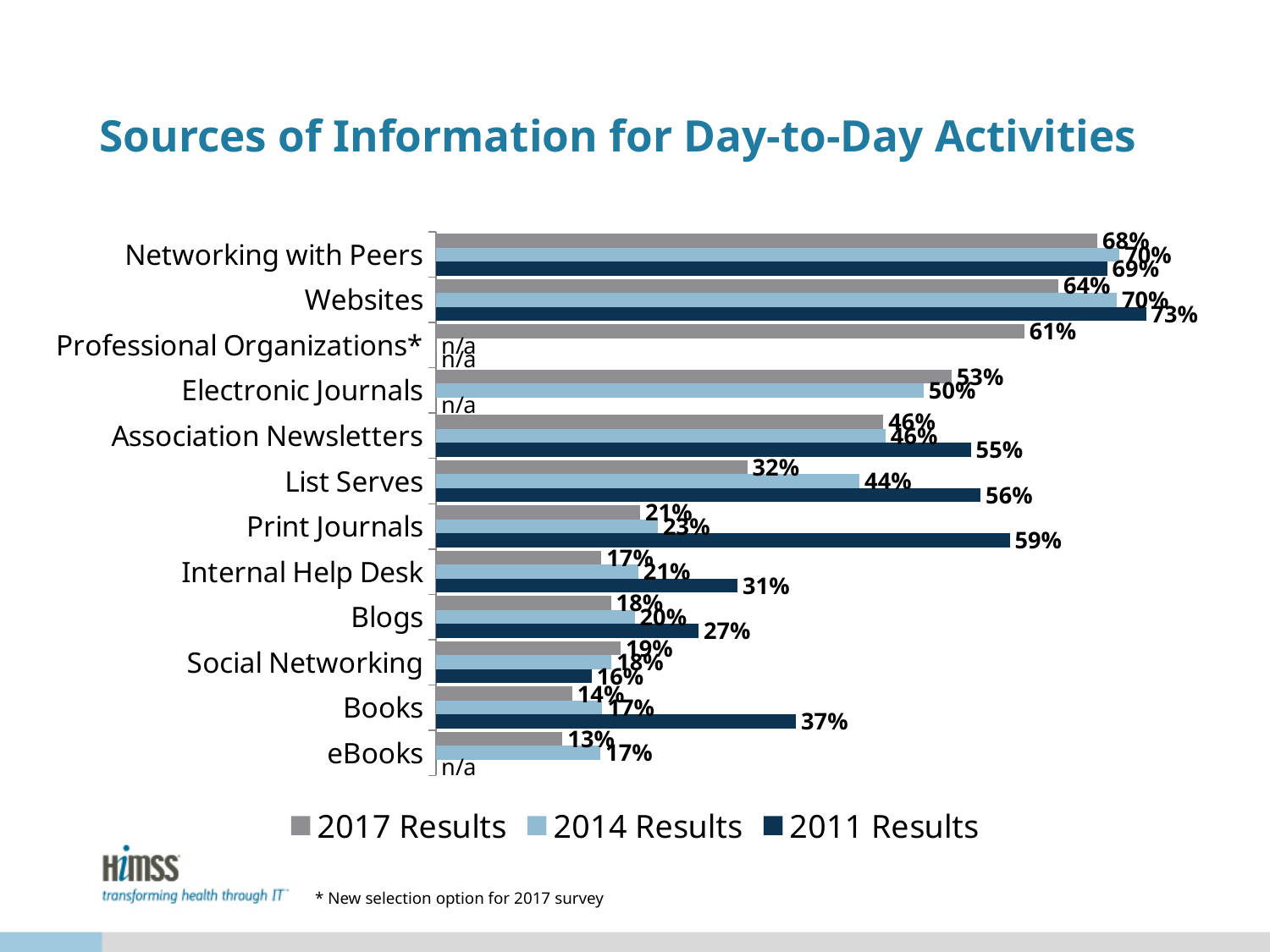
What type of chart is shown on the slide? Bar chart What is the 2017 Results value for Professional Organizations*? 61% What is the 2014 Results value for Electronic Journals? 50% Which series is shown in dark blue in the legend? 2011 Results Which is larger: the 2011 Results value for Print Journals or for Association Newsletters? Print Journals Which category has the lowest 2017 Results value? eBooks What is the 2011 Results value for Books? 37% How many series does the legend list? 3 How many information sources (categories) are plotted on the chart? 12 What is the 2011 Results value for List Serves? 56% What is the difference between the 2011 Results and 2017 Results values for List Serves? 24 percentage points Which category has the highest 2011 Results value? Websites